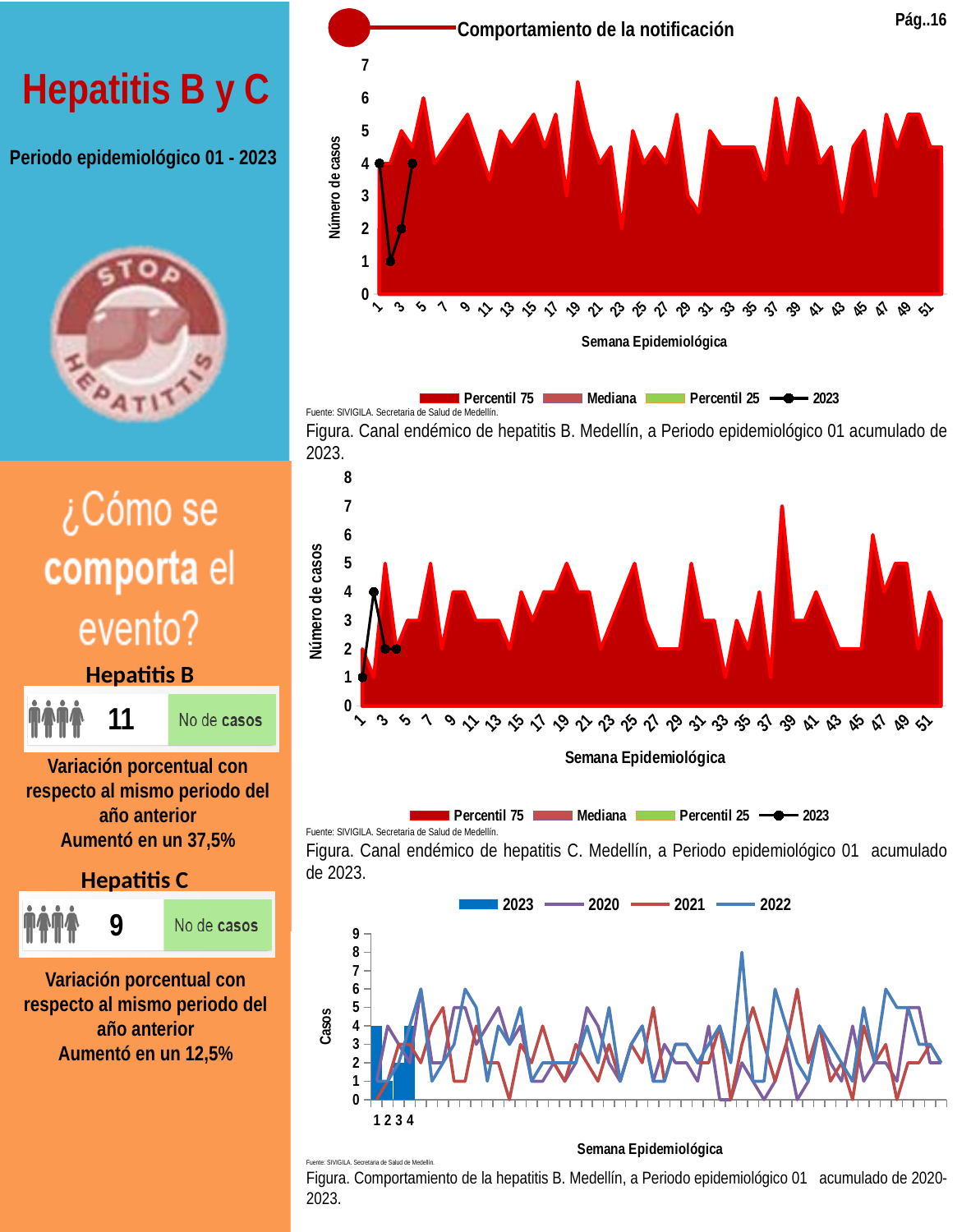
How many series does the legend of the bottom chart ('Comportamiento de la hepatitis B ... 2020-2023') list? 4 In the 'Canal endémico de hepatitis C' chart (middle), what is the 2023 value at epidemiological week 2? 4 In the 'Canal endémico de hepatitis B' chart (top), at which epidemiological week is the 2023 line lowest? Week 2 In the 'Canal endémico de hepatitis C' chart (middle), at which epidemiological week is the 2023 line highest? Week 2 In the 'Canal endémico de hepatitis B' chart (top), what is the difference between the 2023 values at week 1 and week 2? 3 What is the x-axis label of the 'Canal endémico de hepatitis B' chart (top)? Semana Epidemiológica In the 'Canal endémico de hepatitis B' chart (top), what is the 2023 value at epidemiological week 1? 4 In the 'Canal endémico de hepatitis C' chart (middle), what is the 2023 value at epidemiological week 1? 1 In the 'Canal endémico de hepatitis B' chart (top), what is the 2023 value at epidemiological week 2? 1 In the 'Canal endémico de hepatitis B' chart (top), which is larger for 2023: week 1 or week 2? Week 1 In the bottom chart ('Comportamiento de la hepatitis B ... 2020-2023'), which series is drawn as bars rather than a line? 2023 In the 'Canal endémico de hepatitis C' chart (middle), is the 2023 value at week 2 greater or less than 3? greater